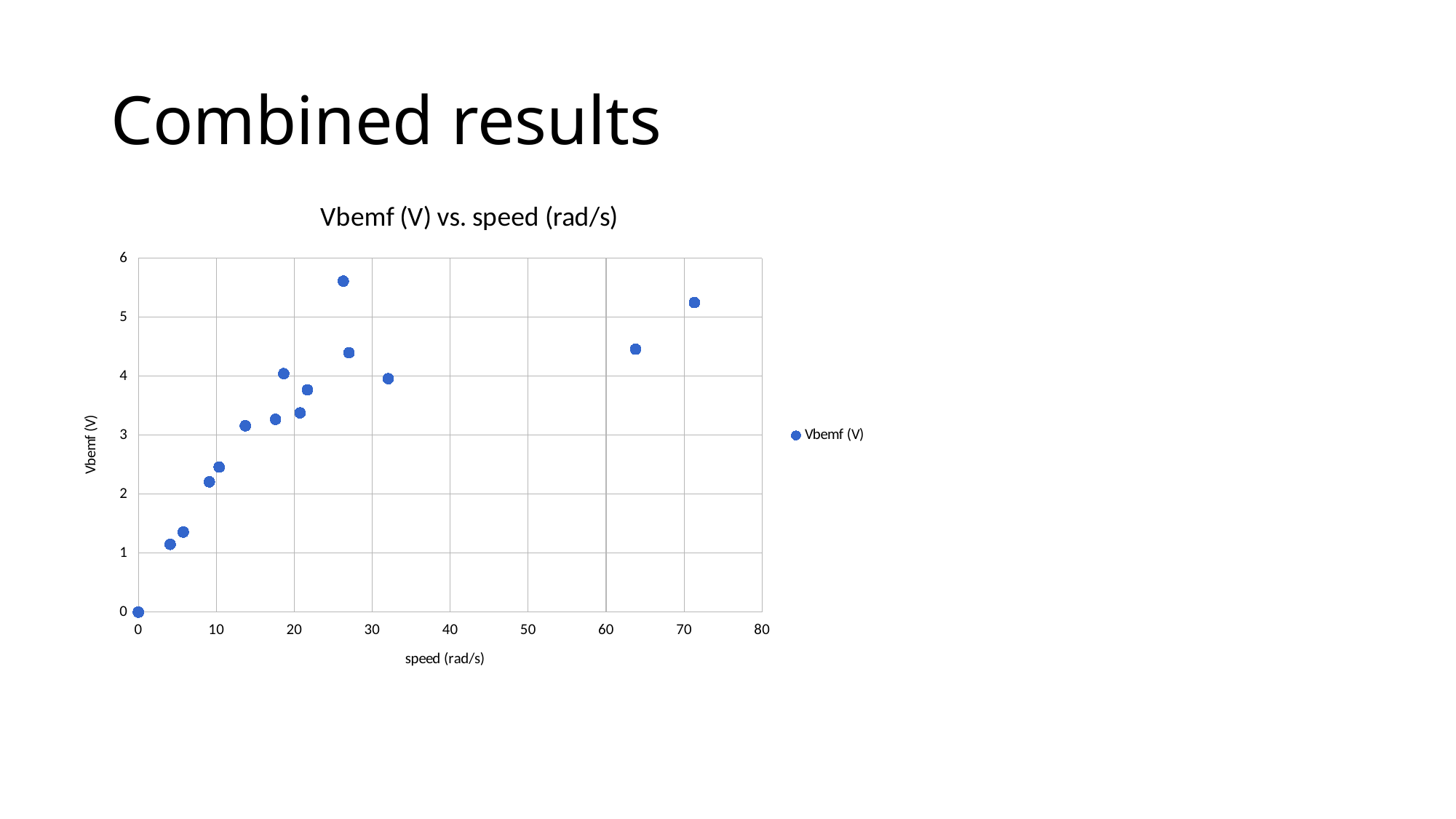
Is the Vbemf value for the point near 70 rad/s greater or less than 5? greater Which has the higher Vbemf value: the point near 26 rad/s or the point near 71 rad/s? the point near 26 rad/s How many series does the legend list? 1 Is the Vbemf value for the point near 9 rad/s greater or less than 3? less Is the Vbemf value for the point near 26 rad/s greater or less than 5? greater What kind of chart is shown on the slide? scatter chart What is the Vbemf value of the point plotted at speed 0 rad/s? 0 What is the label on the x axis of the chart? speed (rad/s) What is the title of the chart? Vbemf (V) vs. speed (rad/s) Do the Vbemf values generally rise or fall as speed increases from 0 to 20 rad/s? rise How many data points are plotted on the chart? 15